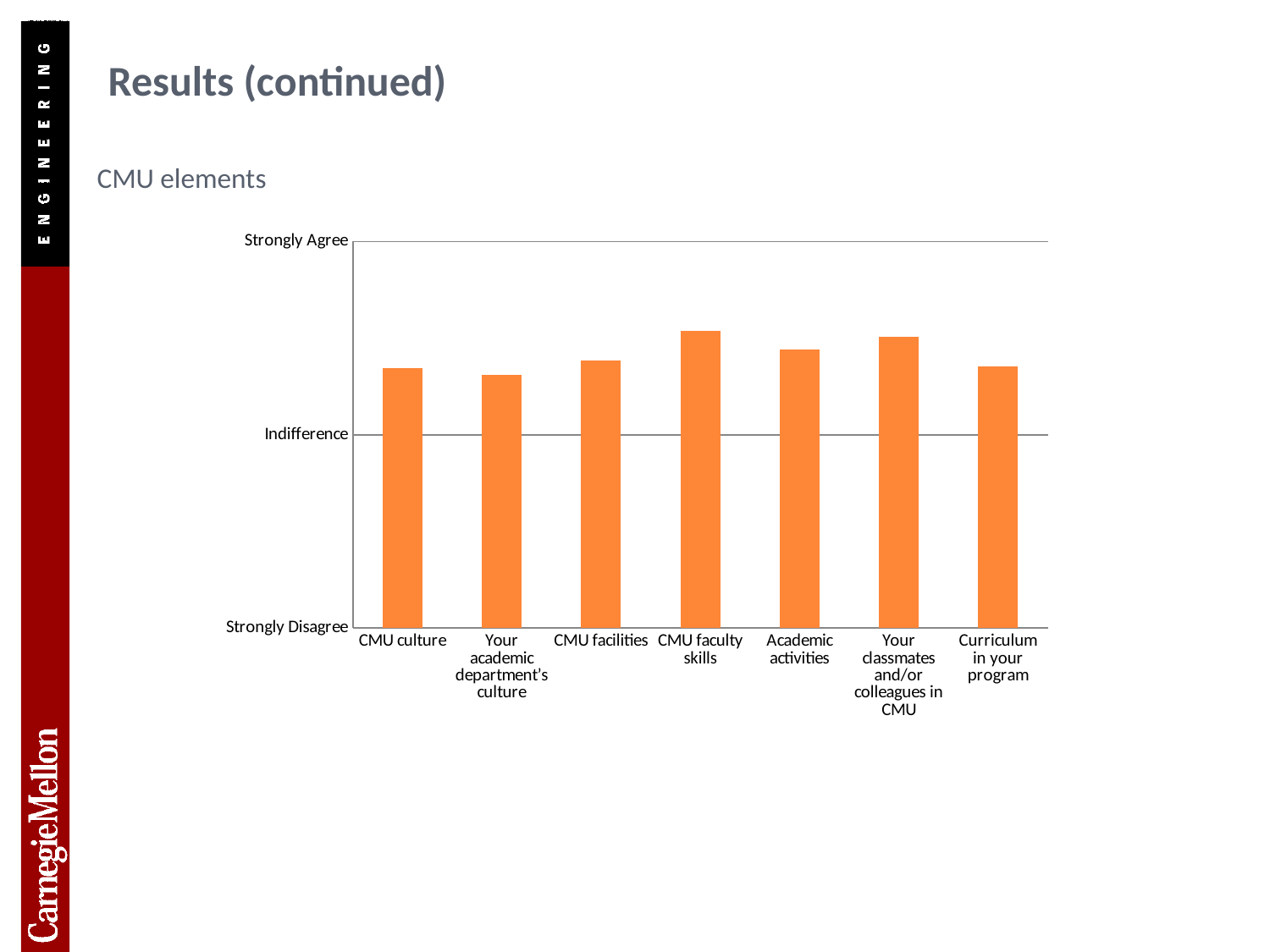
Which is higher, the bar for Academic activities or the bar for Curriculum in your program? Academic activities Which is higher, the bar for CMU faculty skills or the bar for CMU culture? CMU faculty skills Is the bar for Curriculum in your program above or below the Indifference line? above Is the bar for Your academic department's culture above or below the Indifference line? above What kind of chart is shown on the slide? bar chart Which is higher, the bar for Your classmates and/or colleagues in CMU or the bar for Your academic department's culture? Your classmates and/or colleagues in CMU How many categories are plotted on the chart? 7 What colour are the bars in the chart? orange Do any of the bars fall below the Indifference line? No Which category has the highest bar on the chart? CMU faculty skills What is the title of the chart? CMU elements